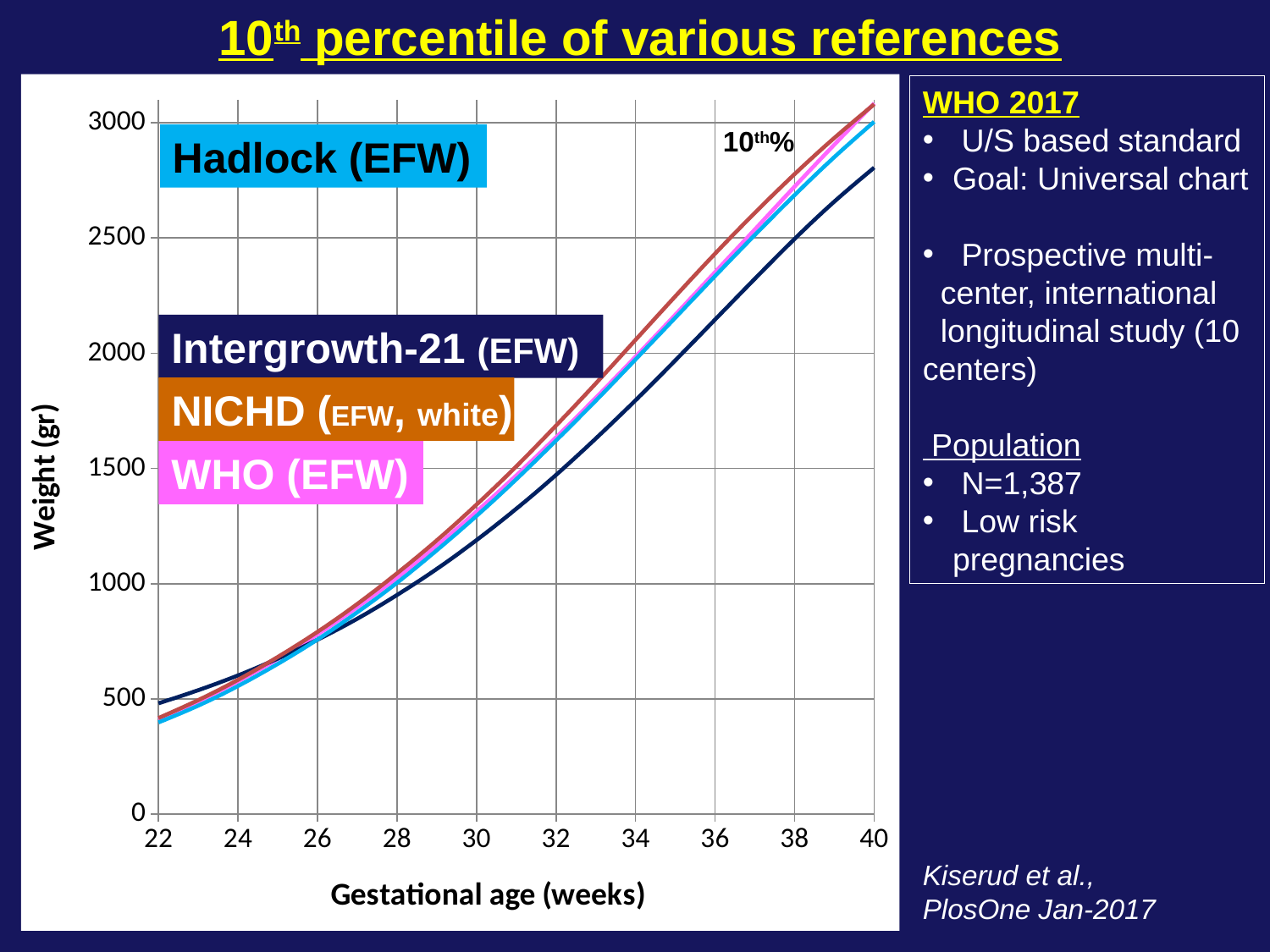
At 40 weeks, which is larger: the NICHD (EFW, white) value or the Intergrowth-21 (EFW) value? NICHD (EFW, white) Is the Intergrowth-21 (EFW) value at 30 weeks greater or less than 1000? greater Is the Intergrowth-21 (EFW) value at 40 weeks greater or less than 3000? less Is the Hadlock (EFW) value at 22 weeks greater or less than 500? less What is the title of the chart on the slide? 10th percentile of various references Which reference has the lowest 10th percentile weight at 40 weeks? Intergrowth-21 (EFW) What kind of chart is shown on the slide? line chart Do the weight curves rise or fall as gestational age increases from 22 to 40 weeks? rise Which reference has the highest 10th percentile weight at 22 weeks? Intergrowth-21 (EFW) How many reference series are plotted on the chart? 4 What is the label of the y axis? Weight (gr)